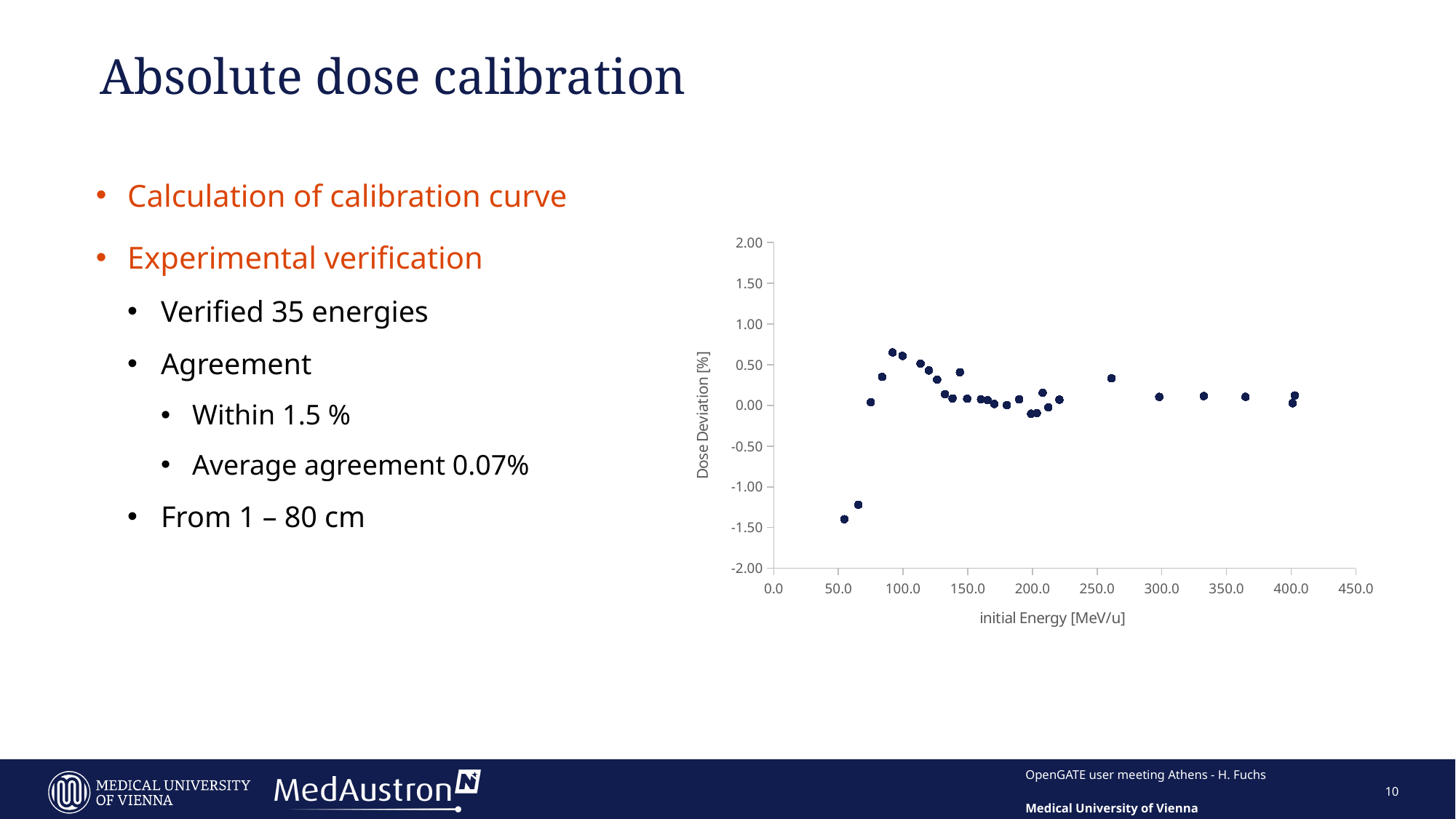
What kind of chart is shown on the slide? scatter chart Is the lowest dose deviation value on the chart greater or less than -1.00? less Is the dose deviation for the point near 55 MeV/u greater or less than -1.50? greater Do the dose deviation values rise or fall as initial energy increases from about 100 to 150 MeV/u? fall Is the dose deviation for the point near 300 MeV/u greater or less than 0.50? less Is the lowest dose deviation found at an initial energy below or above 100 MeV/u? below What is the title of the y axis of the chart? Dose Deviation [%] What is the title of the x axis of the chart? initial Energy [MeV/u] Which has the larger dose deviation: the point near 55 MeV/u or the point near 260 MeV/u? the point near 260 MeV/u Is the highest dose deviation found at an initial energy below or above 100 MeV/u? below